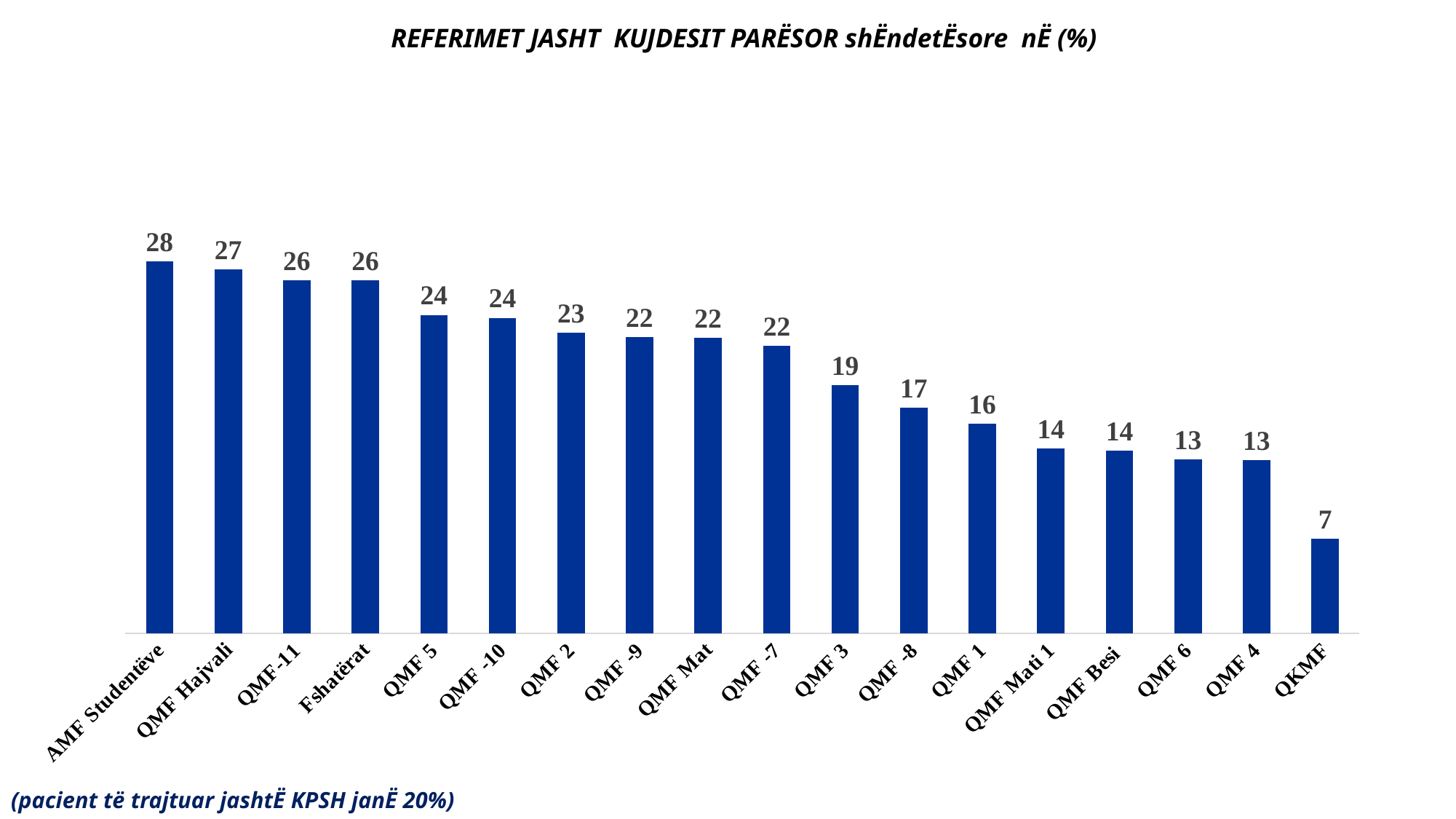
What kind of chart is shown on the slide? Bar chart What is the value for QMF Mat? 22 Which is larger, the value for Fshatërat or the value for QMF 2? Fshatërat What is the value for QMF Besi? 14 What is the difference between the values for QMF Hajvali and QKMF? 20 Which is larger, the value for QMF -8 or the value for QMF 6? QMF -8 Do the values rise or fall from left to right along the x axis? Fall Which category has the highest value? AMF Studentëve What is the value for AMF Studentëve? 28 How many categories are shown on the x axis? 18 Which category has the lowest value? QKMF What is the difference between the values for QMF 3 and QMF 1? 3